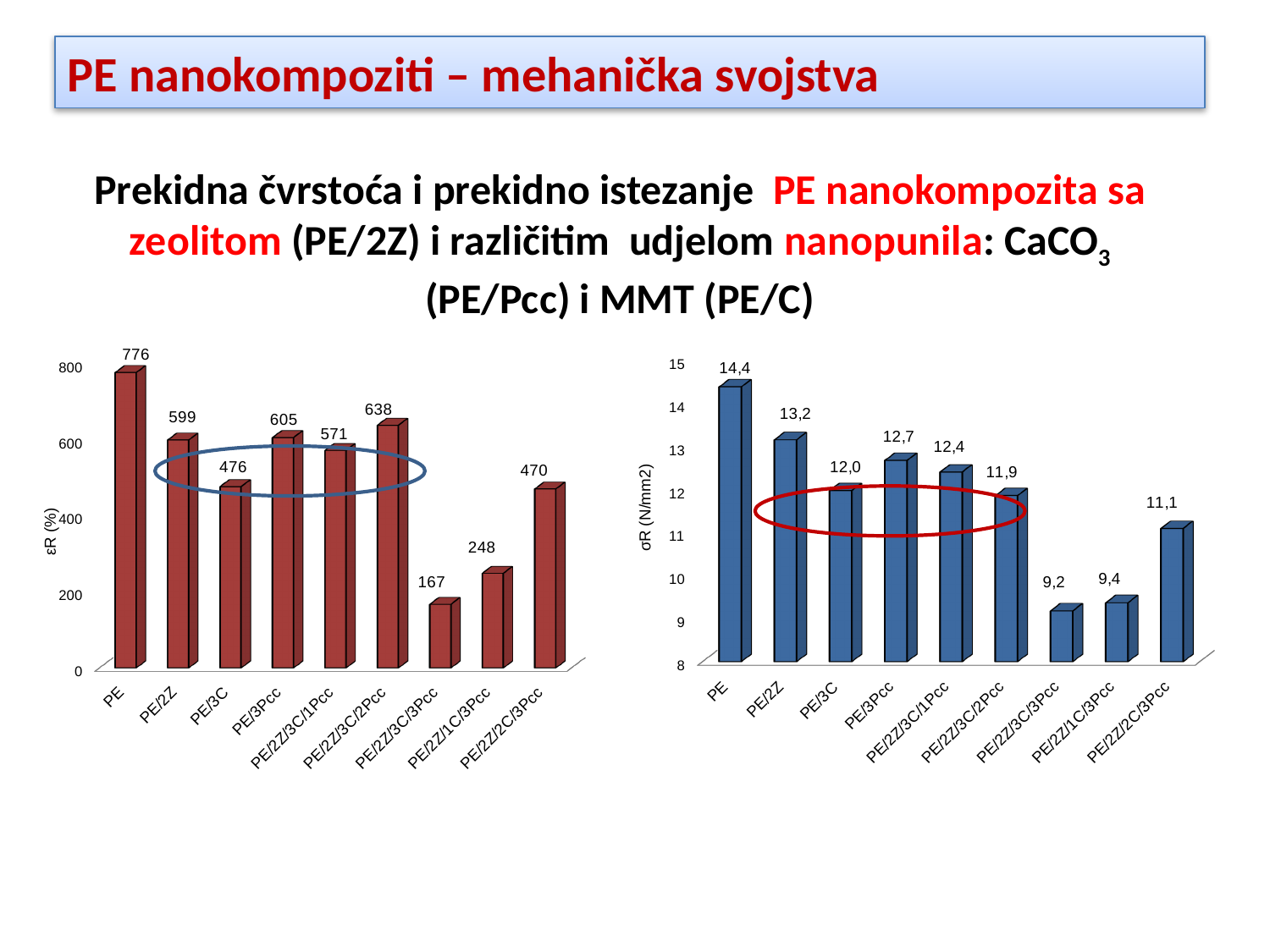
In the right chart (σR (N/mm2)), which is larger, the value for PE/2Z/3C/3Pcc or the value for PE/2Z/1C/3Pcc? PE/2Z/1C/3Pcc In the right chart (σR (N/mm2)), which category has the highest value? PE In the left chart (εR (%)), what is the value for PE? 776 What is the y-axis label of the left chart? εR (%) In the left chart (εR (%)), which category has the lowest value? PE/2Z/3C/3Pcc In the right chart (σR (N/mm2)), what is the value for PE/2Z/2C/3Pcc? 11,1 In the left chart (εR (%)), which is larger, the value for PE/2Z or the value for PE/3Pcc? PE/3Pcc In the right chart (σR (N/mm2)), what is the difference between the values for PE and PE/2Z? 1,2 What kind of chart is the right chart (σR (N/mm2))? bar chart In the right chart (σR (N/mm2)), what is the value for PE/2Z/3C/1Pcc? 12,4 How many categories are shown on the x axis of the left chart (εR (%))? 9 In the left chart (εR (%)), what is the difference between the values for PE/2Z/3C/2Pcc and PE/2Z/3C/1Pcc? 67